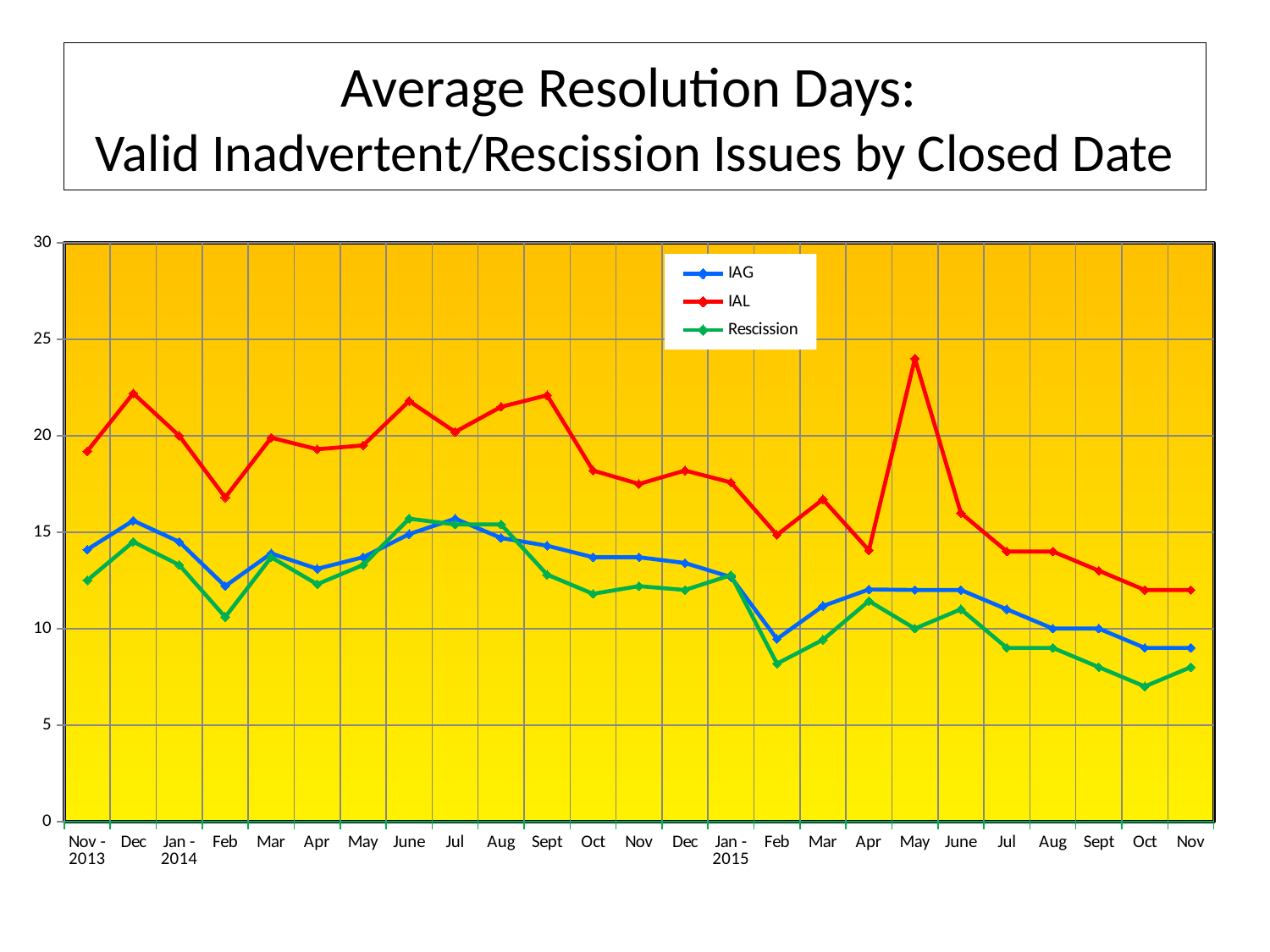
How many series does the legend list? 3 Is the IAL value for May 2015 greater or less than 20? greater What colour is the IAL line in the legend? Red In which month does the IAL series reach its highest value? May 2015 At Nov 2013, which series has the larger value, IAG or IAL? IAL Is the IAL value for Dec 2013 greater or less than 20? greater Is the Rescission value for Oct 2015 greater or less than 10? less What kind of chart is shown on the slide? Line chart Does the IAL series rise or fall from May 2015 to Nov 2015? Fall How many time points are plotted along the x axis? 25 In which month does the Rescission series reach its lowest value? Oct 2015